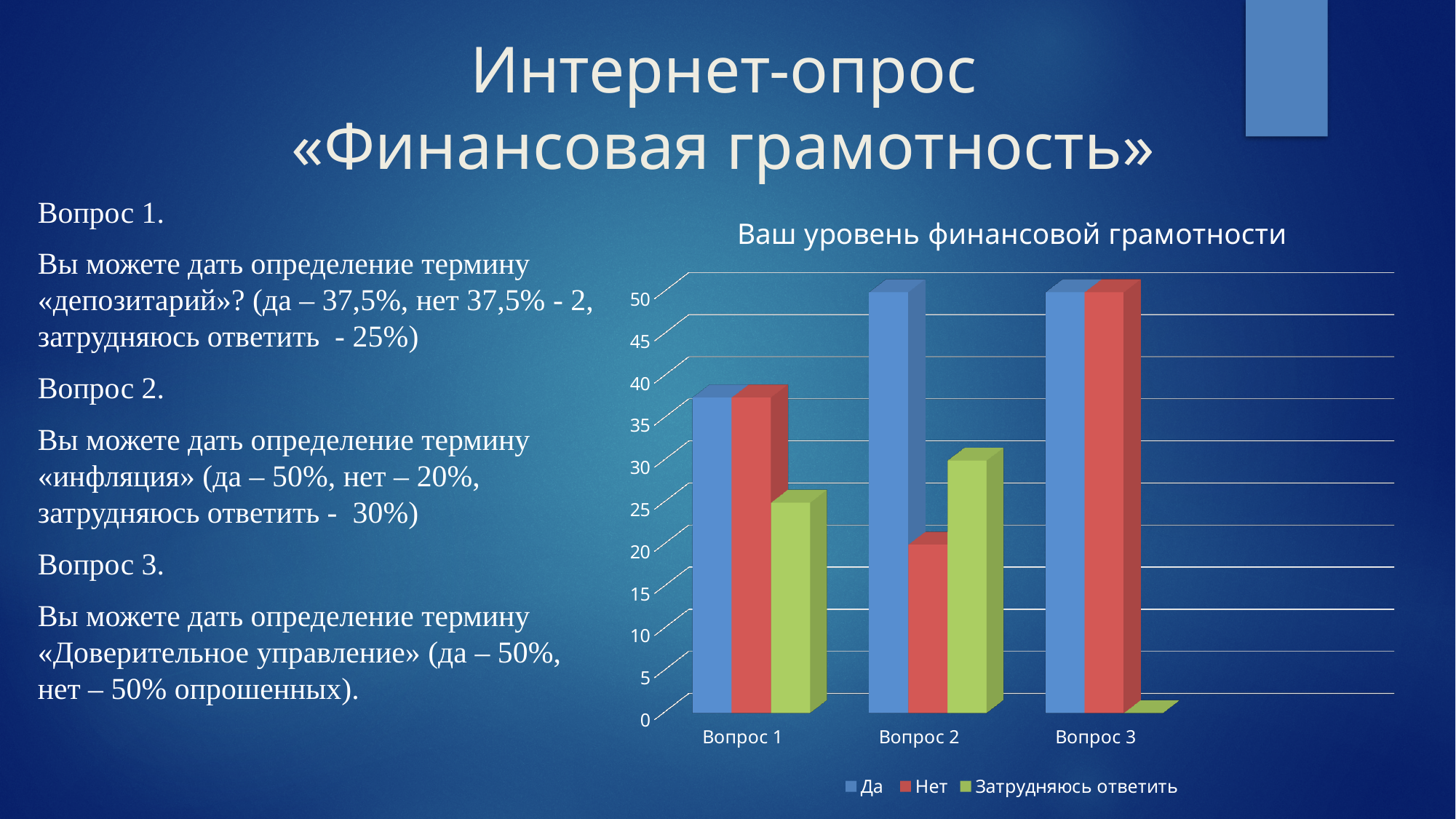
What is the title of the chart? Ваш уровень финансовой грамотности What is the value of the "Нет" series for Вопрос 2? 20 For Вопрос 2, which is larger: the "Нет" value or the "Затрудняюсь ответить" value? Затрудняюсь ответить What is the value of the "Да" series for Вопрос 2? 50 What kind of chart is shown on the slide? bar chart How many categories are shown on the x axis of the chart? 3 Which category has the lowest value for the "Затрудняюсь ответить" series? Вопрос 3 Is the value of the "Нет" series for Вопрос 1 greater or less than 40? less What is the value of the "Затрудняюсь ответить" series for Вопрос 1? 25 How many series does the chart legend list? 3 What is the value of the "Затрудняюсь ответить" series for Вопрос 2? 30 Is the value of the "Да" series for Вопрос 1 greater or less than 35? greater